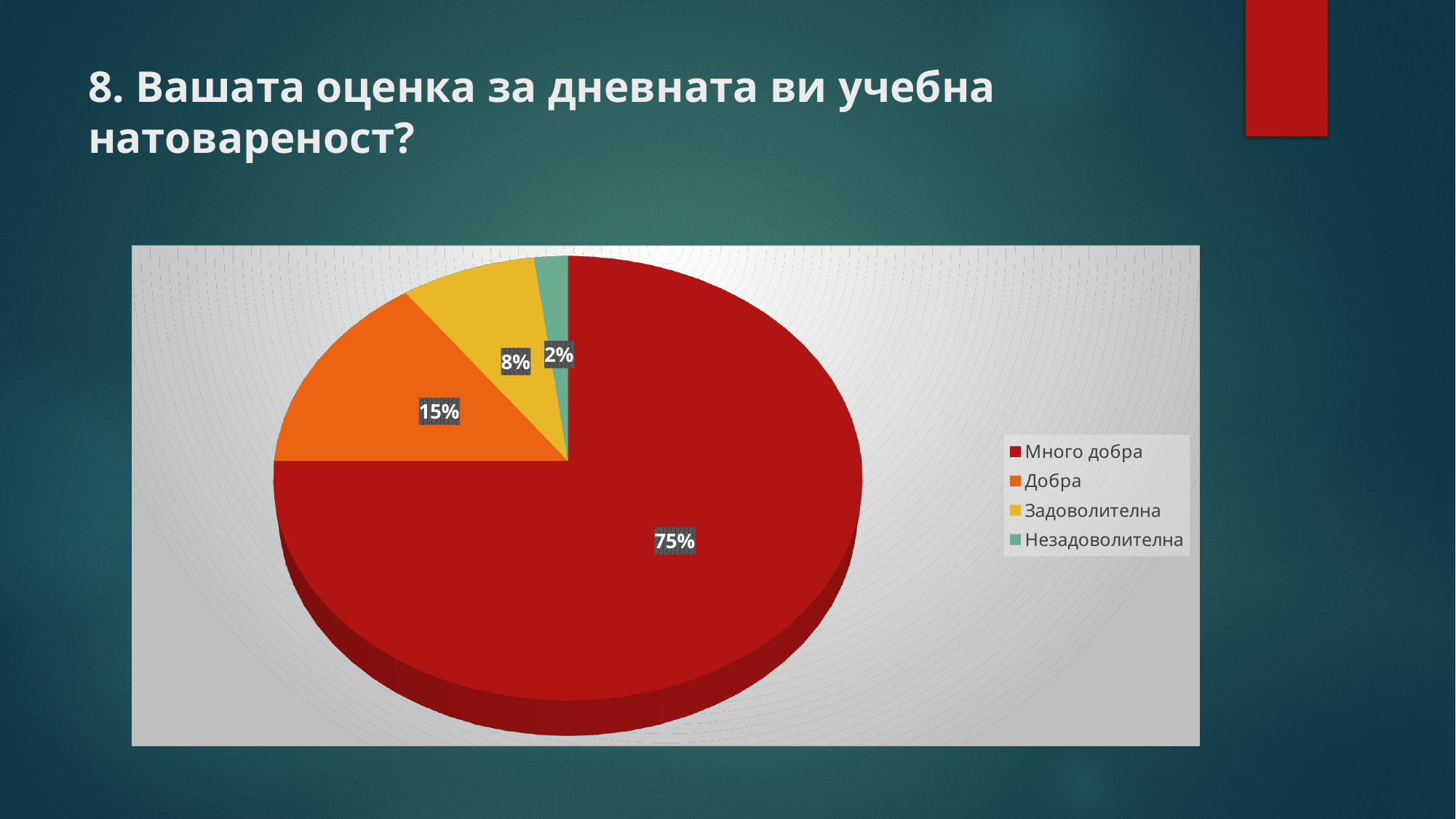
What is the value for "Добра"? 15% Which is larger, the value for "Задоволителна" or the value for "Незадоволителна"? Задоволителна What colour is the slice for "Добра"? orange What share of the pie does "Много добра" have? 75% What is the difference between the values for "Много добра" and "Добра"? 60% What kind of chart is shown on the slide? pie chart What is the value for "Задоволителна"? 8% What is the value for "Незадоволителна"? 2% What is the difference between the values for "Добра" and "Задоволителна"? 7% Which category has the largest slice? Много добра How many categories does the pie chart have? 4 Which category has the smallest slice? Незадоволителна